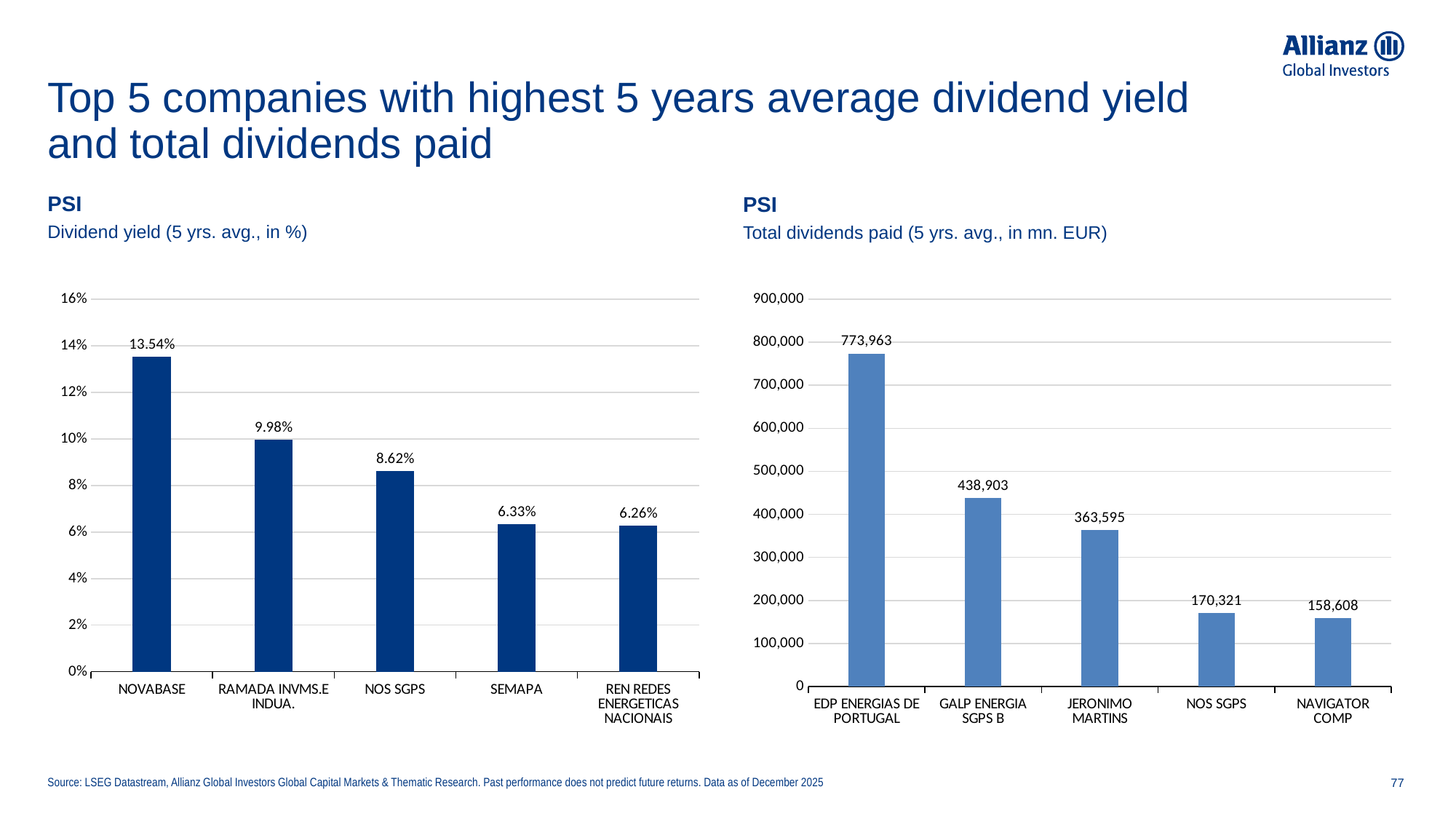
In the Dividend yield chart on the left, what is the value for NOS SGPS? 8.62% In the Dividend yield chart on the left, what is the difference between the values for NOVABASE and RAMADA INVMS.E INDUA.? 3.56% In the Total dividends paid chart on the right, which is larger: the value for NOS SGPS or the value for NAVIGATOR COMP? NOS SGPS In the Dividend yield chart on the left, how many companies are shown? 5 In the Total dividends paid chart on the right, what is the value for GALP ENERGIA SGPS B? 438,903 In the Dividend yield chart on the left, which company has the lowest dividend yield? REN REDES ENERGETICAS NACIONAIS In the Total dividends paid chart on the right, which company has the highest value? EDP ENERGIAS DE PORTUGAL In the Total dividends paid chart on the right, what is the difference between the values for JERONIMO MARTINS and NOS SGPS? 193,274 In the Dividend yield chart on the left, what is the value for NOVABASE? 13.54% In the Dividend yield chart on the left, do the values rise or fall from left to right? fall What type of chart is the Total dividends paid chart on the right? bar chart In the Total dividends paid chart on the right, what is the value for NAVIGATOR COMP? 158,608